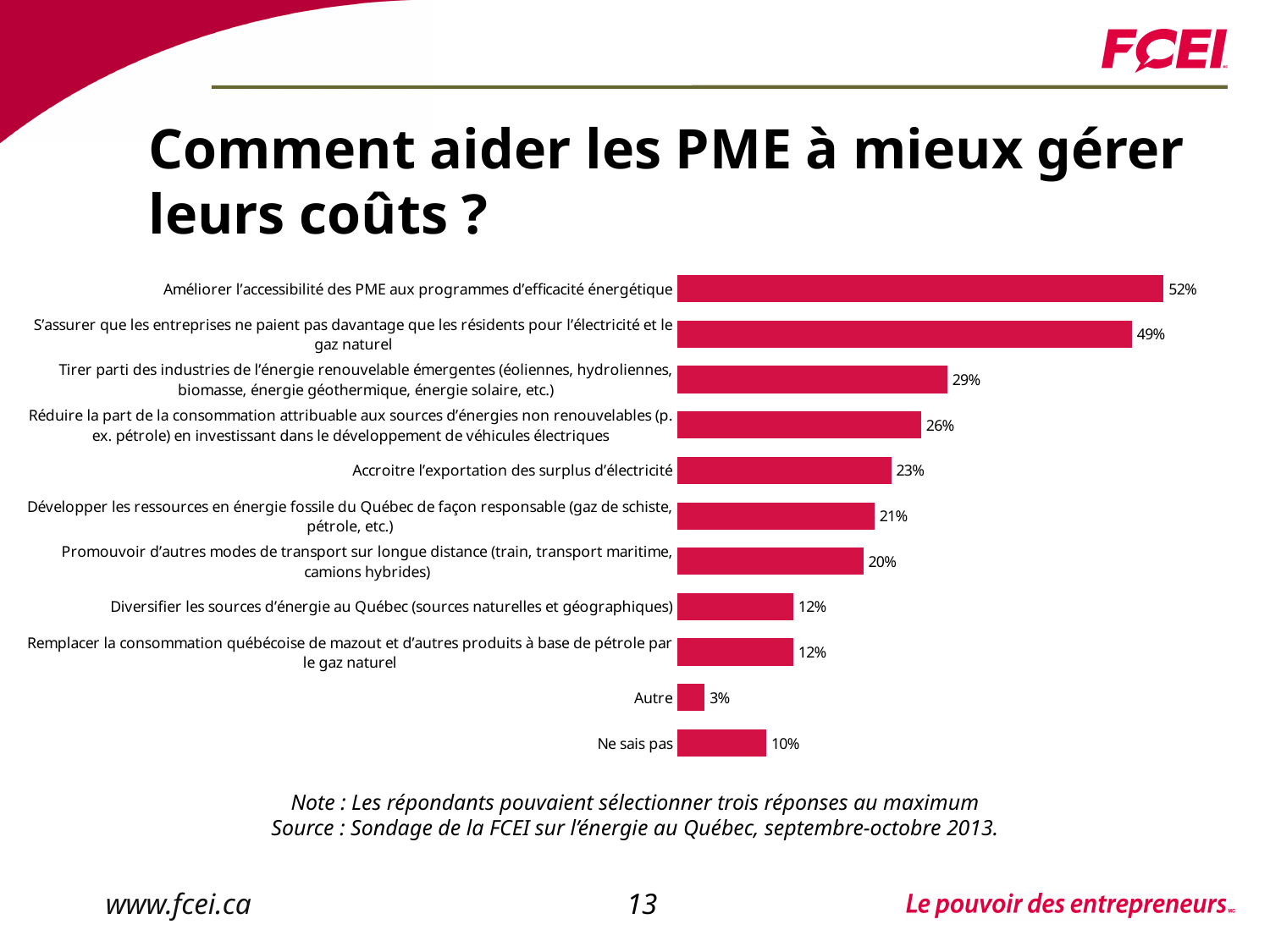
How many categories are shown in the chart? 11 What is the difference between the values for "Améliorer l'accessibilité des PME aux programmes d'efficacité énergétique" and "S'assurer que les entreprises ne paient pas davantage que les résidents pour l'électricité et le gaz naturel"? 3% What is the value for "Accroitre l'exportation des surplus d'électricité"? 23% What is the difference between the values for "Ne sais pas" and "Autre"? 7% Which category has the lowest value? Autre What kind of chart is shown on the slide? Bar chart What is the value for "Améliorer l'accessibilité des PME aux programmes d'efficacité énergétique"? 52% According to the note on the slide, how many responses could respondents select at most? Trois (three) What is the value for "Ne sais pas"? 10% Which is larger: the value for "Tirer parti des industries de l'énergie renouvelable émergentes" or the value for "Accroitre l'exportation des surplus d'électricité"? Tirer parti des industries de l'énergie renouvelable émergentes What is the value for "Promouvoir d'autres modes de transport sur longue distance (train, transport maritime, camions hybrides)"? 20% Which category has the highest value? Améliorer l'accessibilité des PME aux programmes d'efficacité énergétique